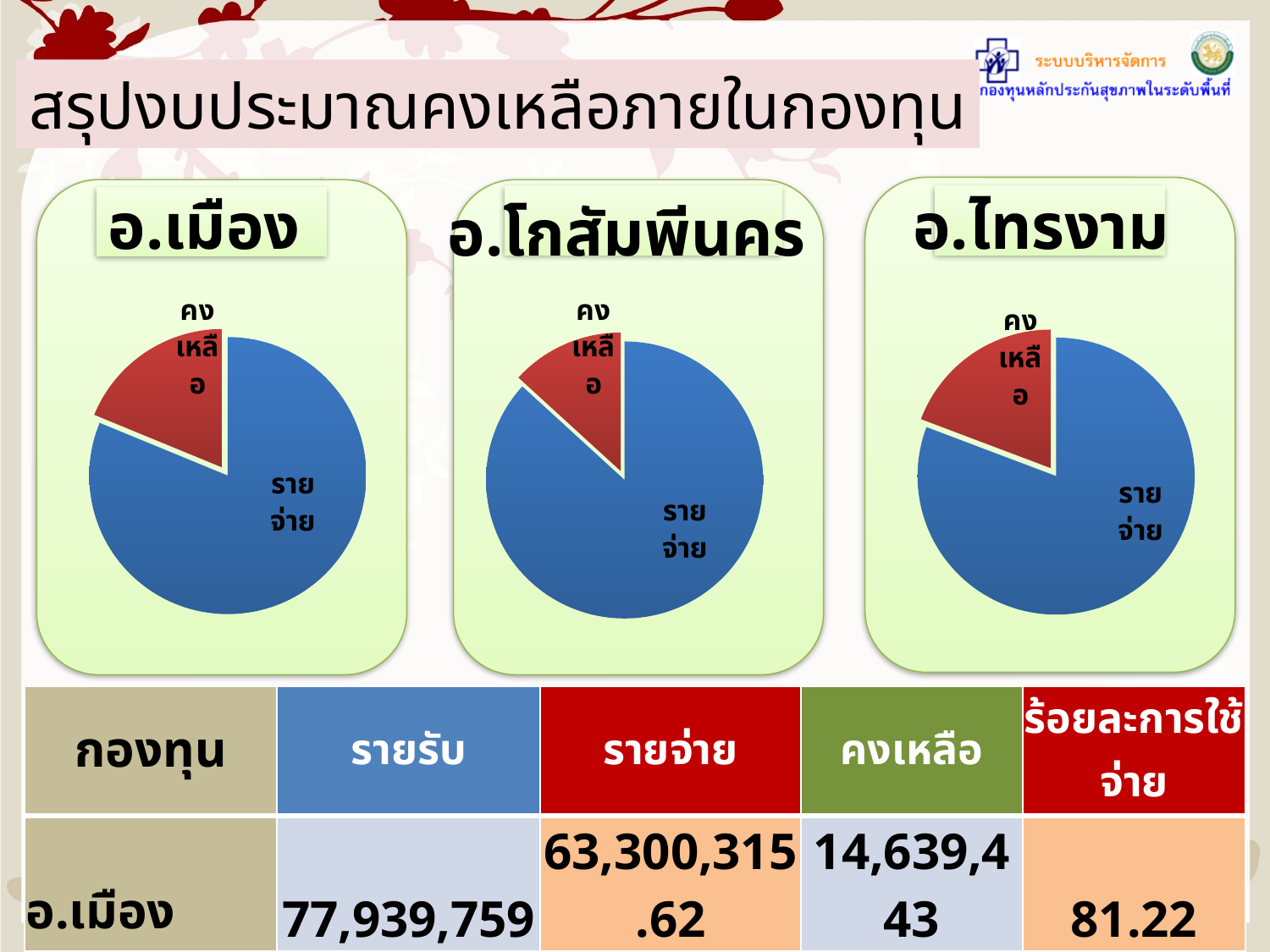
In the อ.เมือง pie chart, which slice is larger, รายจ่าย or คงเหลือ? รายจ่าย In the อ.เมือง pie chart, which category has the smallest slice? คงเหลือ In the อ.ไทรงาม pie chart, which slice is larger, รายจ่าย or คงเหลือ? รายจ่าย In the อ.โกสัมพีนคร pie chart, what colour is the คงเหลือ slice? red In the อ.โกสัมพีนคร pie chart, which slice is larger, คงเหลือ or รายจ่าย? รายจ่าย How many pie charts are shown on the slide? 3 How many slices does the อ.โกสัมพีนคร pie chart have? 2 How many categories are shown in the อ.ไทรงาม pie chart? 2 What kind of chart is the อ.ไทรงาม chart? pie chart What kind of chart is the อ.เมือง chart? pie chart In the อ.ไทรงาม pie chart, which category has the largest slice? รายจ่าย